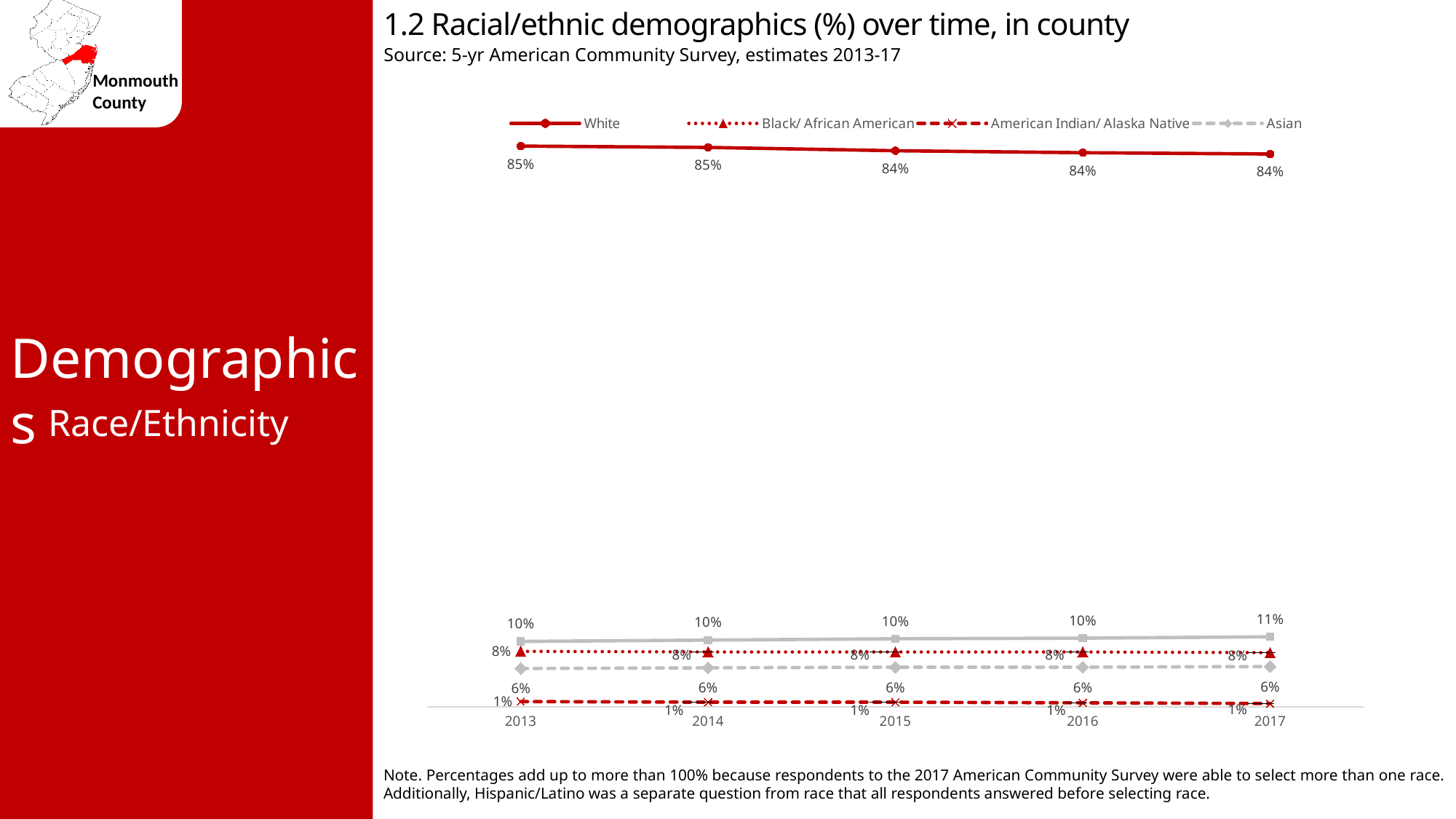
By how many percentage points did the White value change from 2013 to 2017? 1 percentage point How many years are shown on the x axis? 5 What is the value for Asian in 2015? 6% What is the value for American Indian/ Alaska Native in 2016? 1% What kind of chart is this? Line chart What is the value for White in 2017? 84% In 2016, which is larger: Black/ African American or Asian? Black/ African American What is the value for White in 2013? 85% Which series has the highest value in 2017? White What is the value for Black/ African American in 2014? 8% Does the White series rise or fall from 2013 to 2017? Fall Which series has the lowest value in 2013? American Indian/ Alaska Native